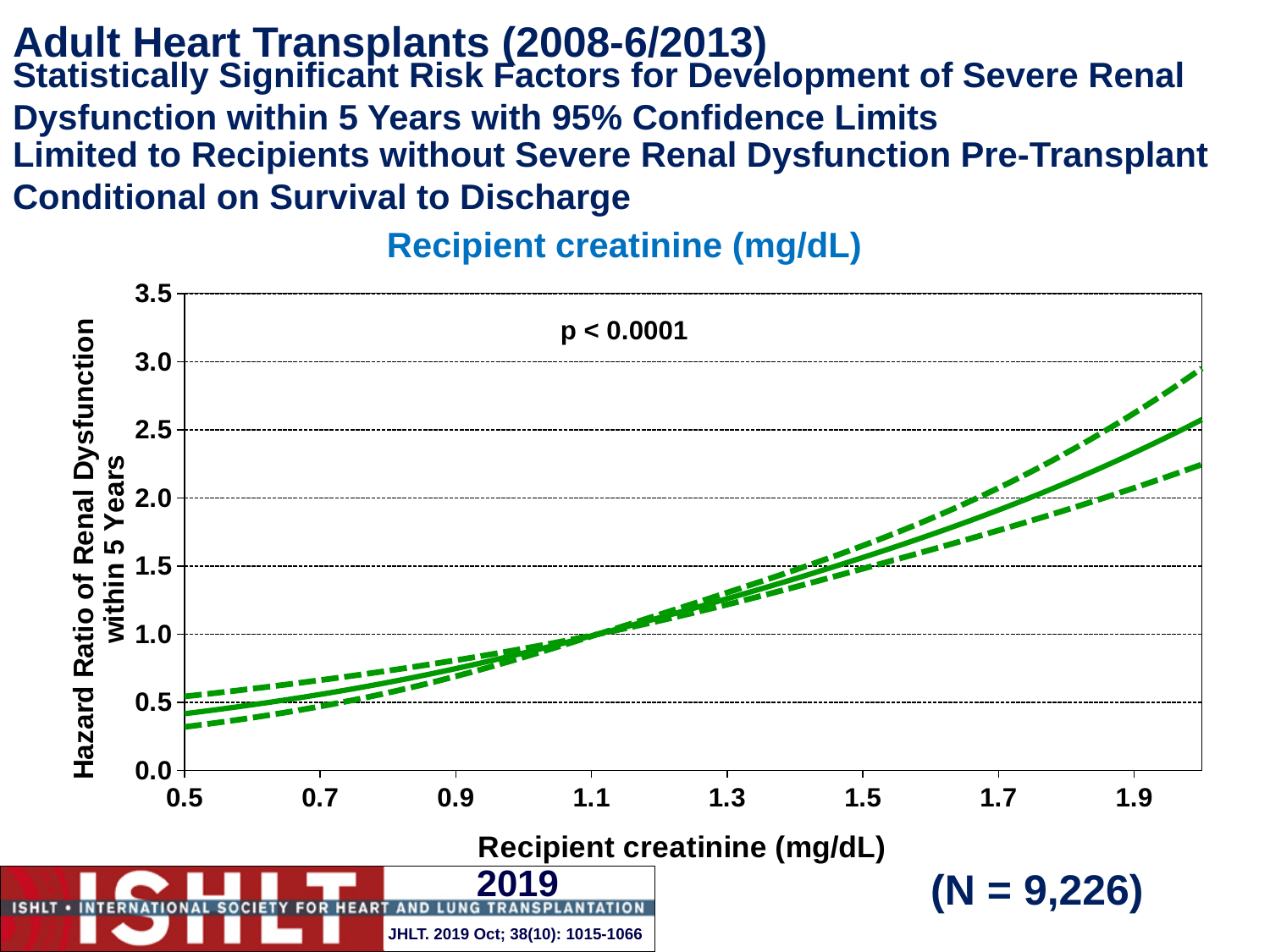
Is the hazard ratio (solid line) at a recipient creatinine of 0.9 mg/dL greater or less than 1.0? less Is the hazard ratio (solid line) at a recipient creatinine of 0.5 mg/dL greater or less than 0.5? less What p-value is printed on the chart? p < 0.0001 How many lines are plotted on the chart? 3 What is the highest value shown on the y axis of the chart? 3.5 Is the hazard ratio (solid line) at a recipient creatinine of 1.9 mg/dL greater or less than 2.0? greater What kind of chart is shown on the slide? line chart Does the hazard ratio rise or fall as recipient creatinine increases along the x axis? rises